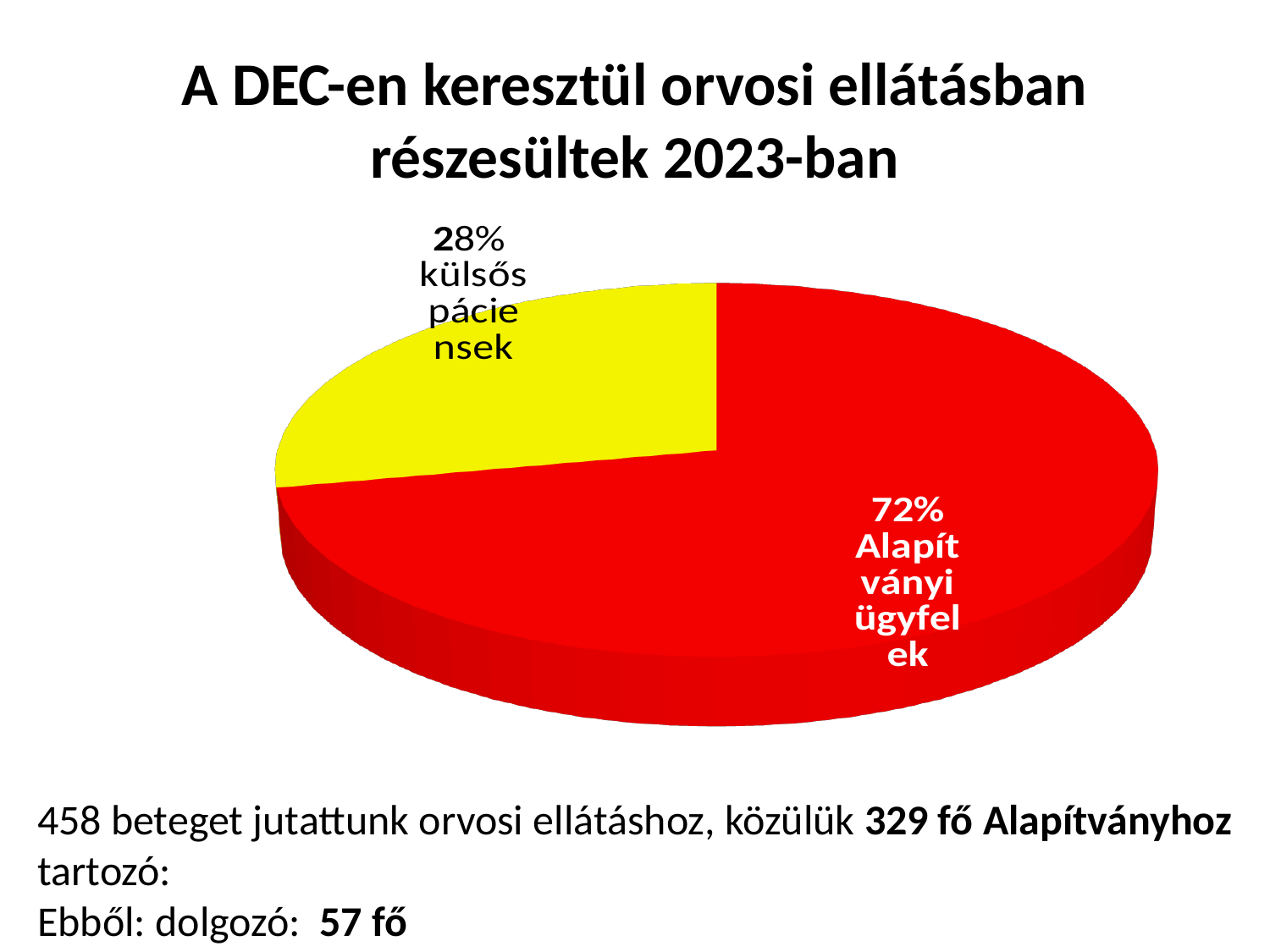
What is the difference in percentage points between the 'Alapítványi ügyfelek' and 'külsős páciensek' slices? 44 What share of the pie does the 'külsős páciensek' slice represent? 28% Which slice of the pie is the smallest? külsős páciensek What colour is the 'külsős páciensek' slice? yellow Which slice of the pie is the largest? Alapítványi ügyfelek Which is larger: the 'külsős páciensek' slice or the 'Alapítványi ügyfelek' slice? Alapítványi ügyfelek What kind of chart is shown on the slide? pie chart What share of the pie does the 'Alapítványi ügyfelek' slice represent? 72% How many slices does the pie chart have? 2 What colour is the 'Alapítványi ügyfelek' slice? red Is the share of 'külsős páciensek' greater or less than 50%? less